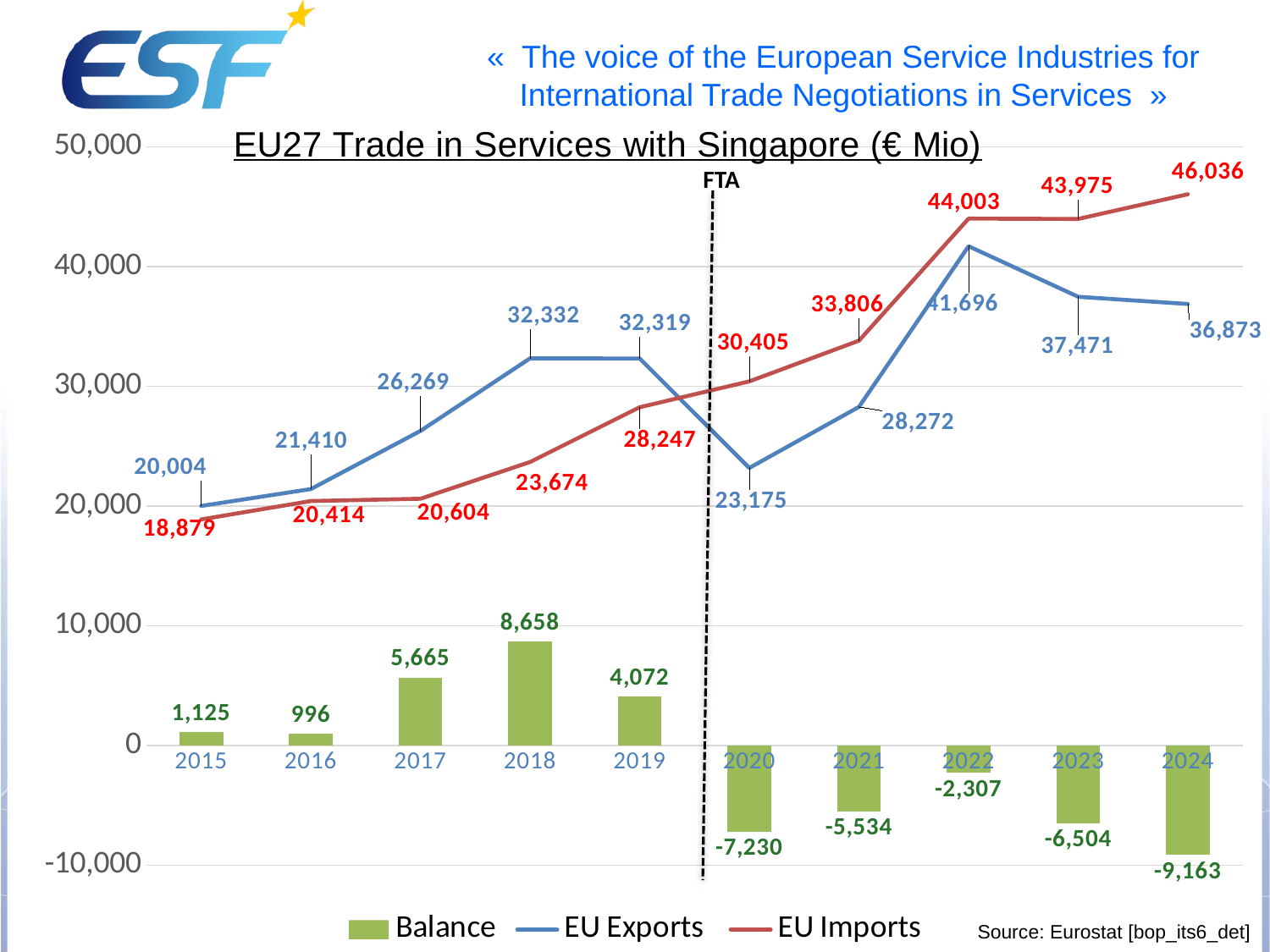
What is the value of EU Exports in 2022? 41,696 What is the Balance value for 2024? -9,163 What is the title of the chart? EU27 Trade in Services with Singapore (€ Mio) In which year is EU Imports highest? 2024 In which year is the Balance lowest? 2024 What is the difference between EU Imports and EU Exports in 2024? 9,163 What is the Balance value for 2018? 8,658 Does EU Imports rise or fall from 2015 to 2022? rise Which is larger in 2019, EU Exports or EU Imports? EU Exports How many series does the legend list? 3 How many years are shown on the x axis? 10 What is the value of EU Imports in 2015? 18,879